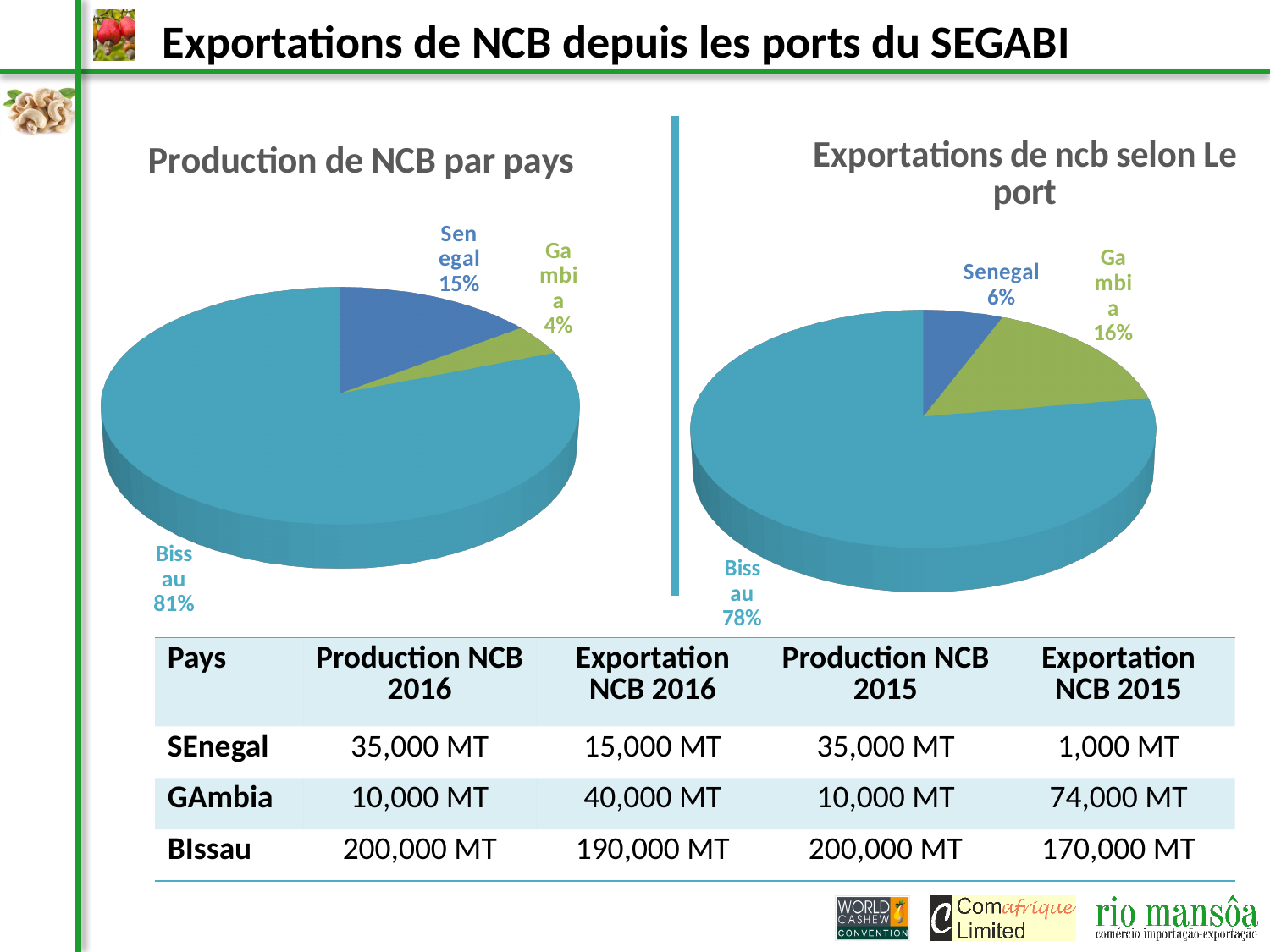
In the 'Production de NCB par pays' chart, which country has the smallest slice? Gambia In the 'Production de NCB par pays' chart, what is the difference between Senegal's share and Gambia's share? 11% In the 'Exportations de ncb selon Le port' chart, what share does Gambia have? 16% In the 'Production de NCB par pays' chart, what share does Gambia have? 4% In the 'Production de NCB par pays' chart, which country has the largest slice? Bissau In the 'Exportations de ncb selon Le port' chart, which port has the smallest slice? Senegal In the 'Production de NCB par pays' chart, what share does Senegal have? 15% In the 'Exportations de ncb selon Le port' chart, which is larger, Senegal or Gambia? Gambia What type of chart is the 'Exportations de ncb selon Le port' chart? Pie chart